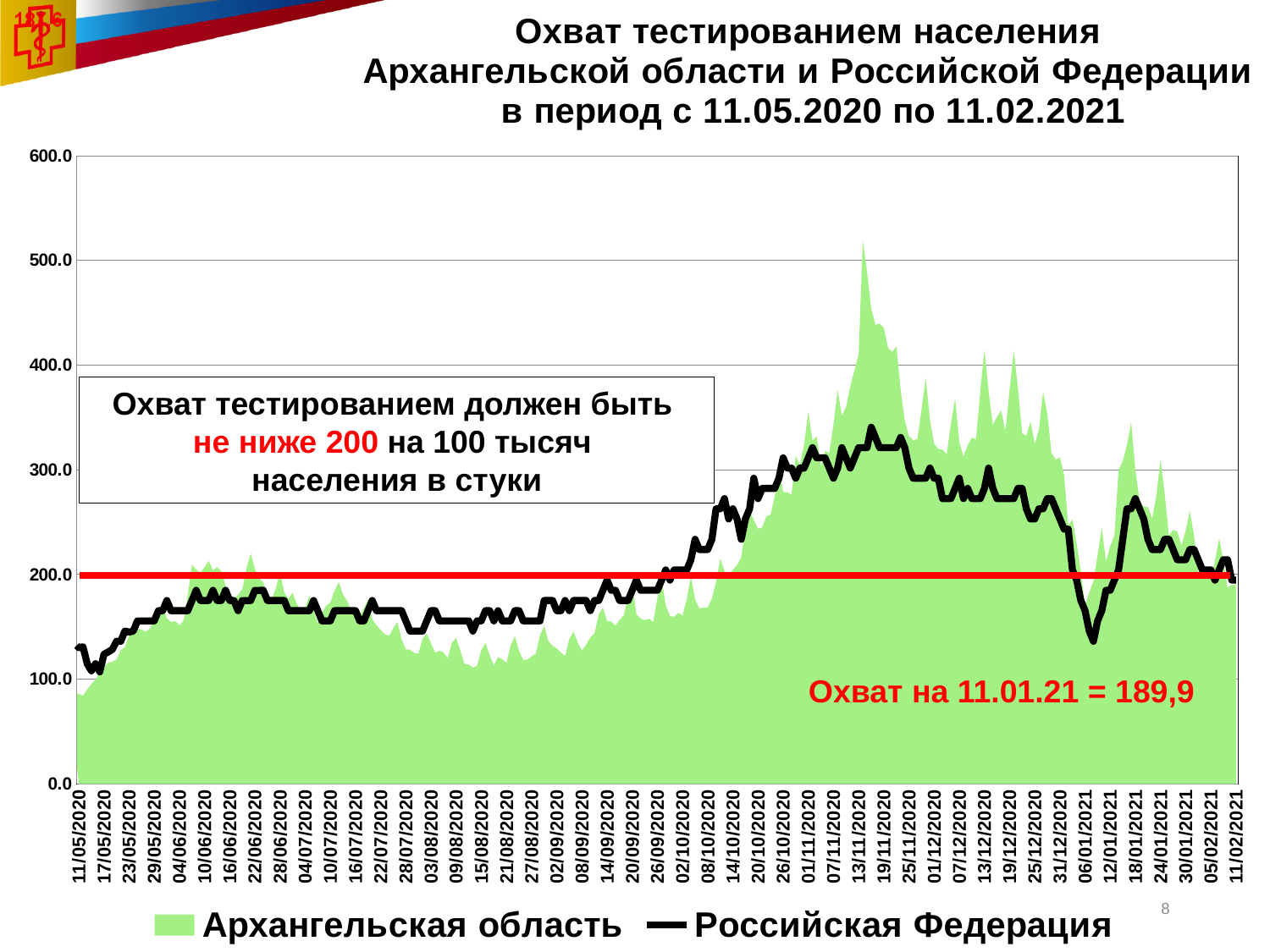
Is the value for Архангельская область on 11/05/2020 greater or less than 100? less Is the peak value for Российская Федерация around 13/11/2020 greater or less than 400? less At what level is the red horizontal threshold line drawn on the chart? 200 What coverage value does the annotation on the chart give for 11.01.21? 189,9 Does the value for Российская Федерация rise or fall between 11/05/2020 and 10/06/2020? rise Which series is shown as a green filled area? Архангельская область Around 09/08/2020, which series has the higher value, Архангельская область or Российская Федерация? Российская Федерация What kind of chart is shown on the slide? An area chart with a line series Is the peak value for Архангельская область around 13/11/2020 greater or less than 500? greater How many series does the legend list? 2 Around 13/11/2020, which series has the higher value, Архангельская область or Российская Федерация? Архангельская область